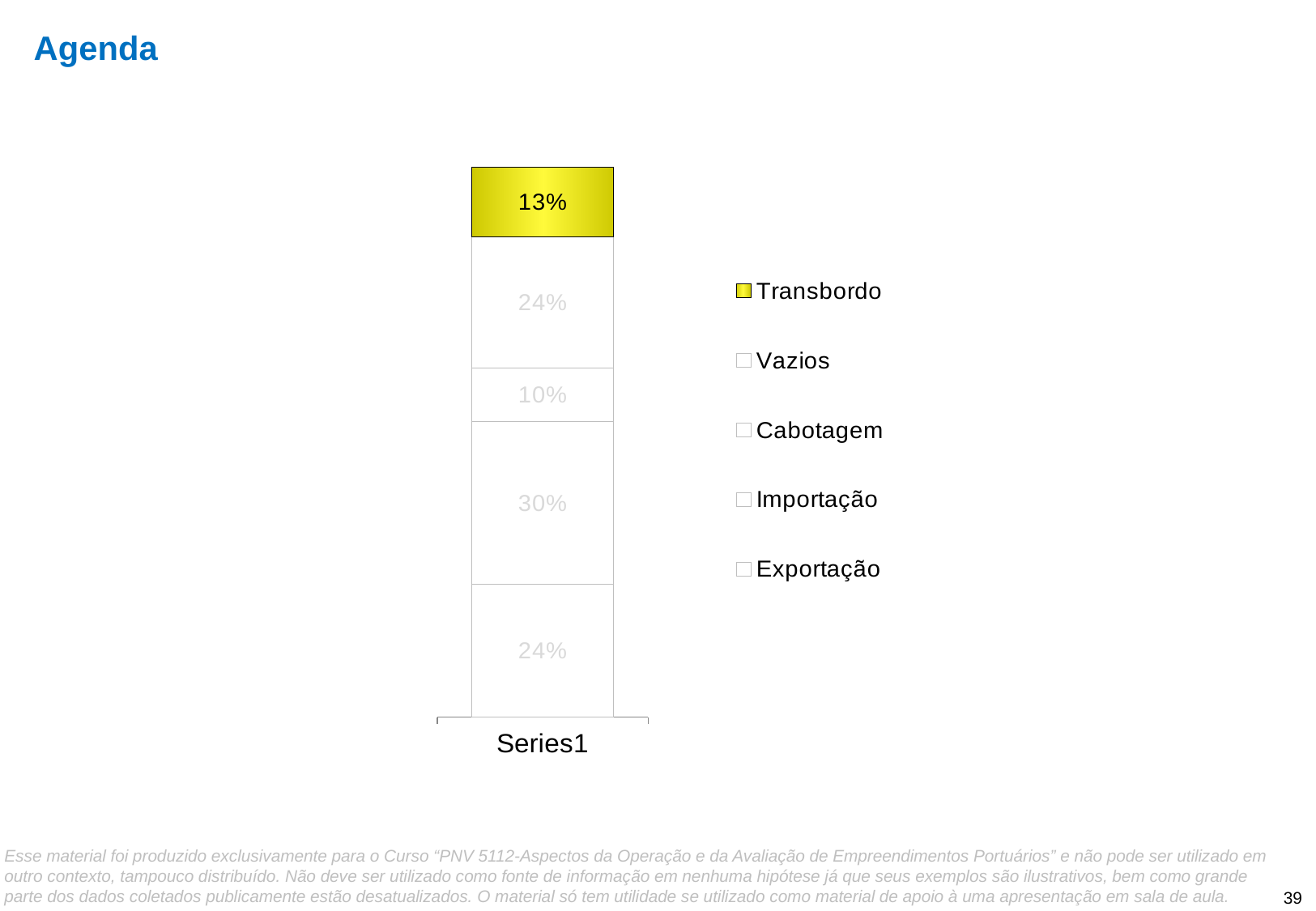
What is the value of the largest segment in the stacked bar? 30% What kind of chart is shown on the slide? Stacked bar chart What is the category label shown on the x axis? Series1 How many segments make up the stacked bar? 5 What is the difference between the Transbordo segment (13%) and the 10% segment? 3% What is the value of the Transbordo segment? 13% What is the value of the bottom segment of the stacked bar? 24% What is the value of the smallest segment in the stacked bar? 10% Which legend entry is highlighted in yellow? Transbordo How many series does the legend list? 5 What is the difference between the largest segment (30%) and the smallest segment (10%)? 20% Which is larger, the top segment of the bar or the bottom segment? The bottom segment